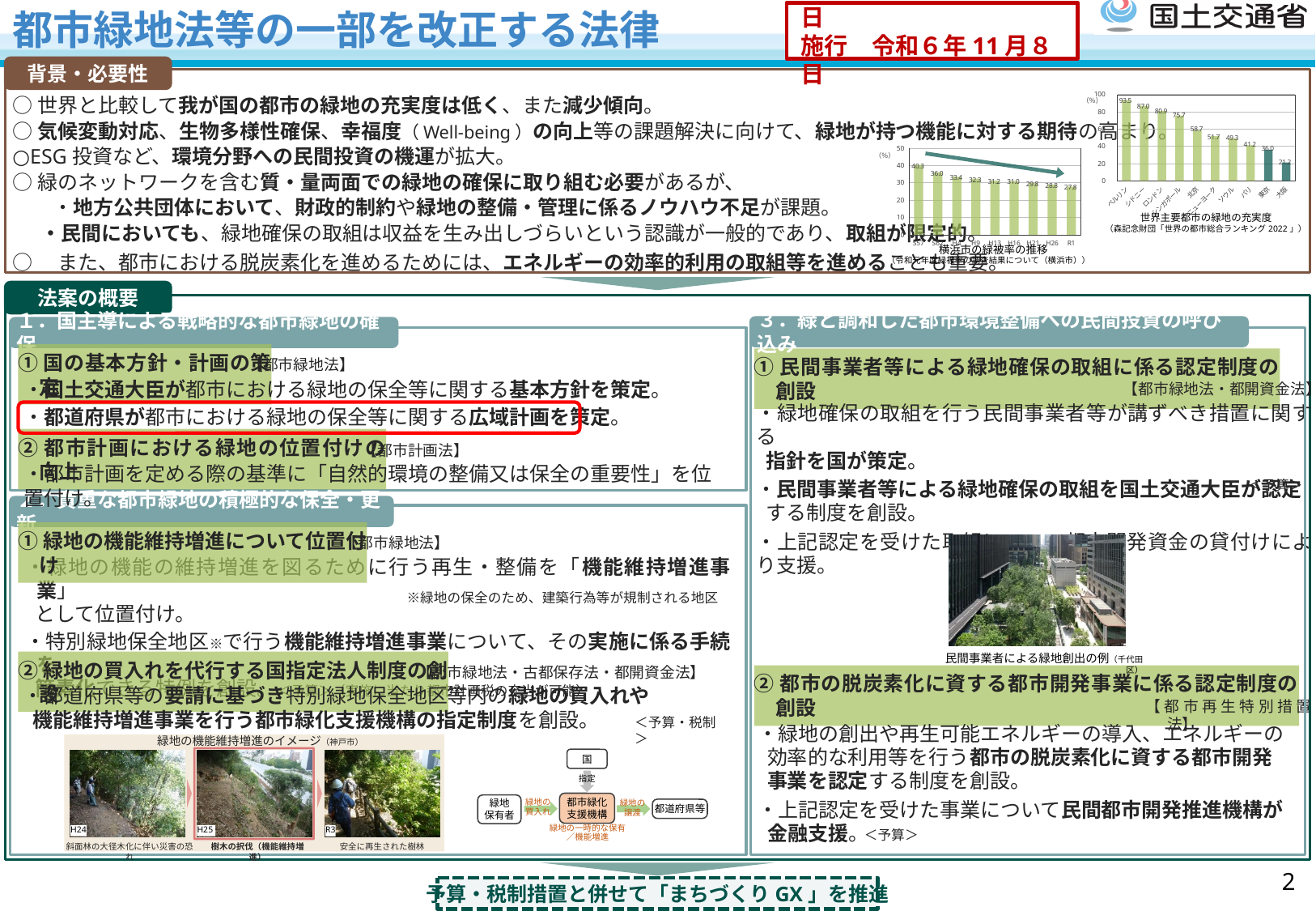
In the chart 「世界主要都市の緑地の充実度」, what is the difference between the values for 東京 and 大阪? 14.8 In the chart 「横浜市の緑被率の推移」, how many bars are plotted? 9 In the chart 「横浜市の緑被率の推移」, what is the lowest value shown? 27.8 In the chart 「世界主要都市の緑地の充実度」, which city has the lowest value? 大阪 In the chart 「世界主要都市の緑地の充実度」, what is the value for 東京? 36.0 In the chart 「世界主要都市の緑地の充実度」, how many cities are shown? 10 In the chart 「横浜市の緑被率の推移」, do the values rise or fall along the x axis? fall In the chart 「横浜市の緑被率の推移」, what is the highest value shown? 40.3 In the chart 「世界主要都市の緑地の充実度」, which is larger, the value for 東京 or the value for 大阪? 東京 What kind of chart is the chart titled 「世界主要都市の緑地の充実度」? bar chart In the chart 「世界主要都市の緑地の充実度」, what is the value for 大阪? 21.2 In the chart 「世界主要都市の緑地の充実度」, which city has the highest value? ベルリン